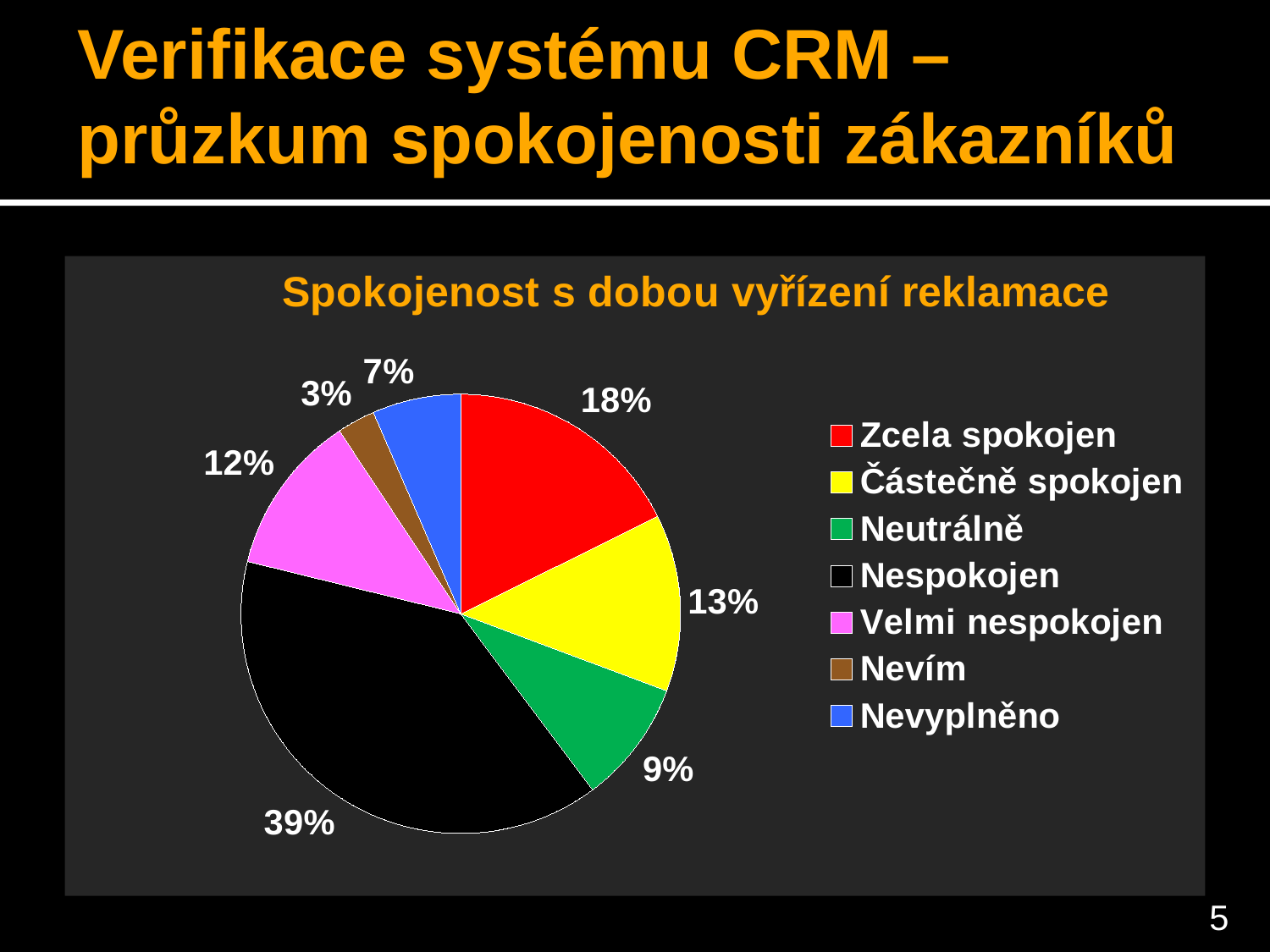
Which category has the largest slice of the pie? Nespokojen What type of chart is shown on the slide? pie chart How many categories does the legend list? 7 What colour is the 'Nevyplněno' slice? blue What is the difference between the shares of 'Zcela spokojen' and 'Částečně spokojen'? 5% What share of the pie is 'Velmi nespokojen'? 12% Which is larger, the share of 'Neutrálně' or the share of 'Nevyplněno'? Neutrálně What share of the pie is 'Zcela spokojen'? 18% What share of the pie is 'Nevím'? 3% Which category has the smallest slice of the pie? Nevím What is the title of the chart? Spokojenost s dobou vyřízení reklamace